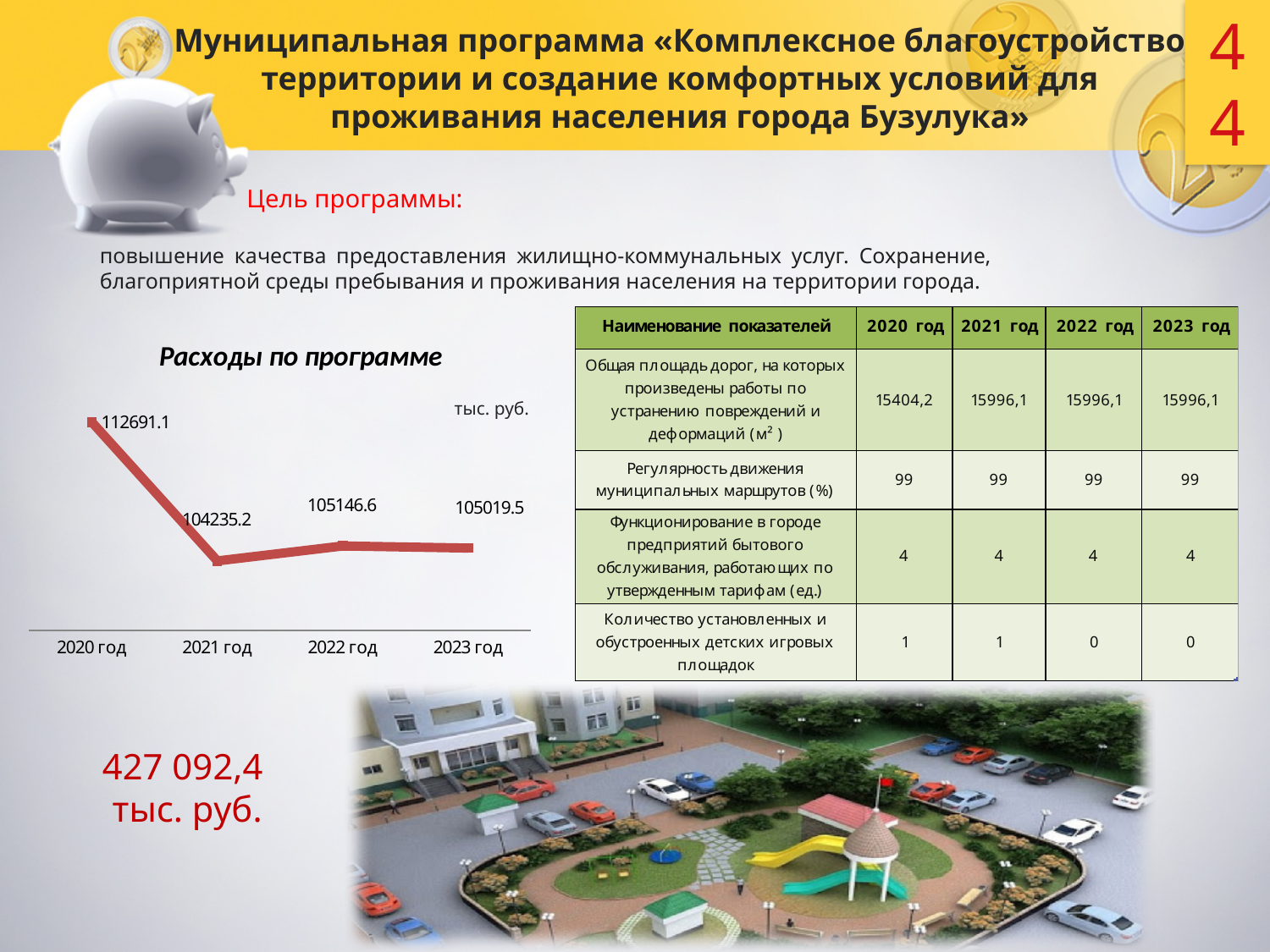
What is the value for 2020 год in the "Расходы по программе" chart? 112691.1 What is the value for 2022 год in the "Расходы по программе" chart? 105146.6 What type of chart is "Расходы по программе"? line chart In the "Расходы по программе" chart, what is the difference between the values for 2020 год and 2021 год? 8455.9 In the "Расходы по программе" chart, does the value rise or fall from 2020 год to 2021 год? fall Which year has the highest value in the "Расходы по программе" chart? 2020 год What unit is shown on the "Расходы по программе" chart? тыс. руб. Which year has the lowest value in the "Расходы по программе" chart? 2021 год How many years are plotted in the "Расходы по программе" chart? 4 What is the value for 2023 год in the "Расходы по программе" chart? 105019.5 In the "Расходы по программе" chart, which is larger: the value for 2022 год or 2023 год? 2022 год What is the value for 2021 год in the "Расходы по программе" chart? 104235.2